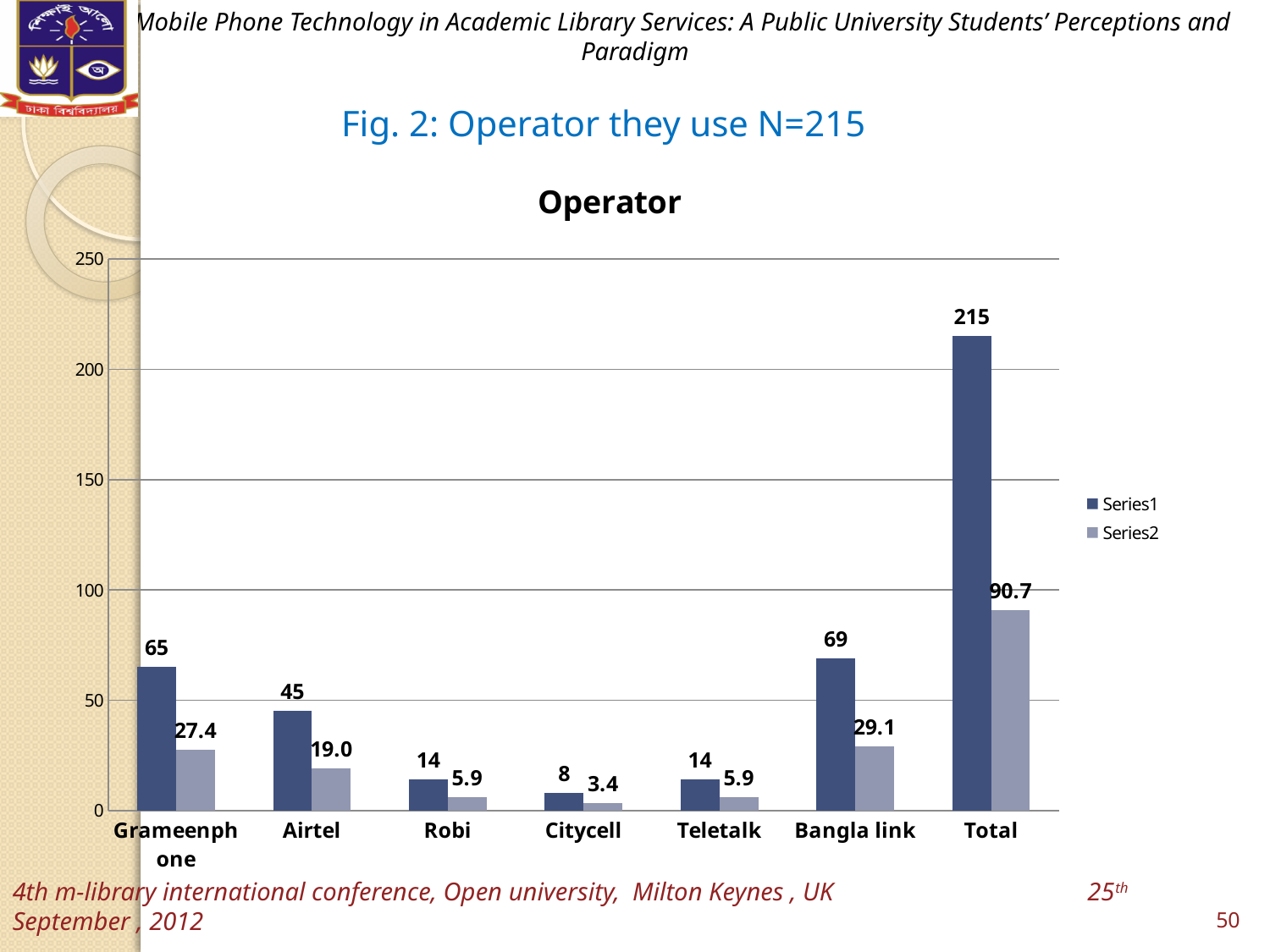
Excluding the Total bar, which operator has the highest Series1 value? Bangla link What is the title of the chart? Operator Which operator has the lowest Series1 value? Citycell Is the Series1 value for Total greater or less than 200? greater What is the Series1 value for Grameenphone? 65 What type of chart is shown? bar chart What is the Series2 value for Total? 90.7 Which is larger, the Series1 value for Airtel or for Grameenphone? Grameenphone What is the Series2 value for Bangla link? 29.1 How many series does the legend list? 2 What is the difference between the Series1 values for Bangla link and Grameenphone? 4 How many categories are shown on the x axis? 7